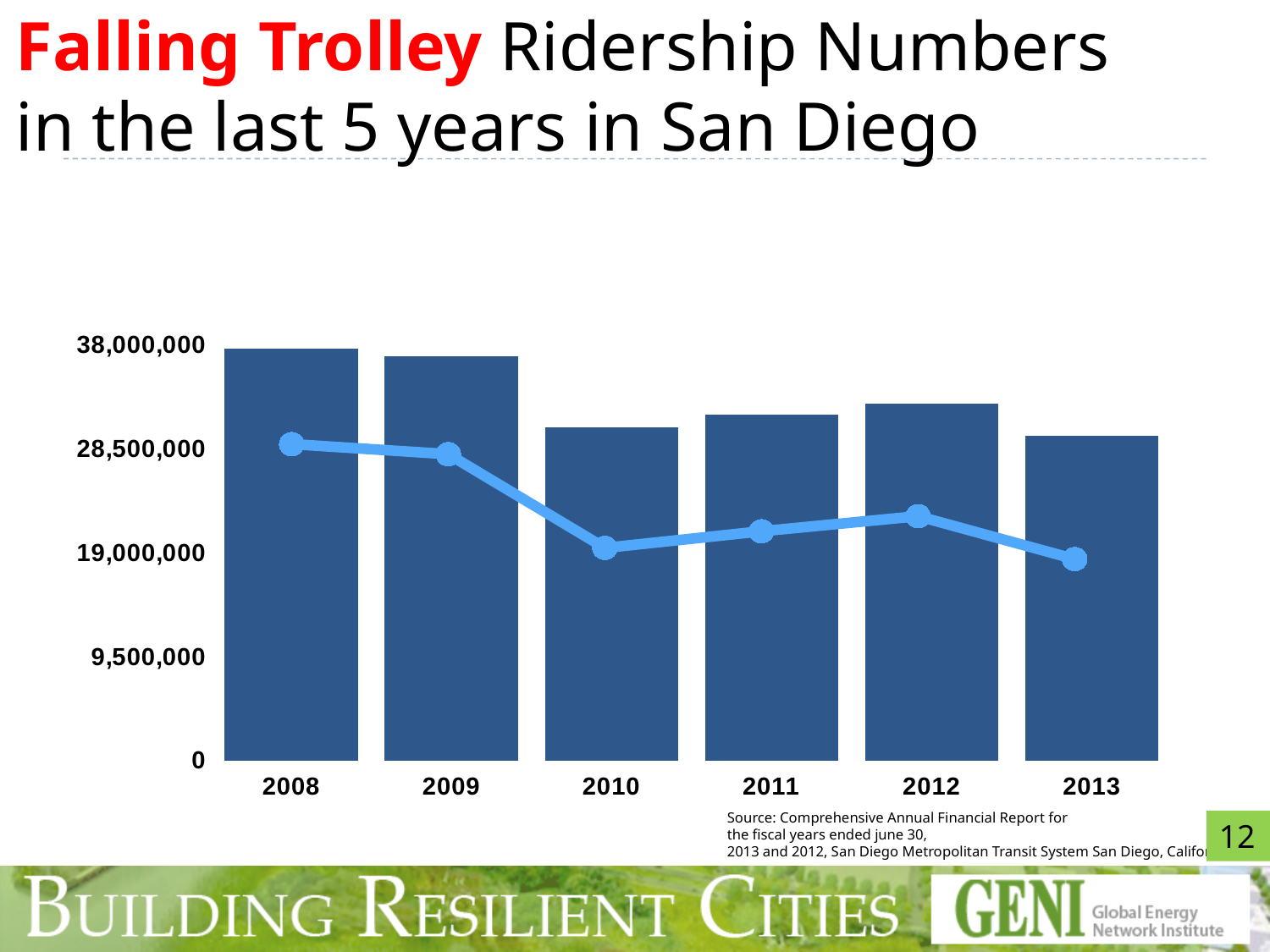
Is the bar for 2010 greater or less than 28,500,000? greater What kind of chart is shown on the slide? A bar chart with a line overlaid Which year has the tallest bar in the chart? 2008 Do the bar values generally rise or fall from 2008 to 2013? fall Which year has the shortest bar in the chart? 2013 Is the line point for 2012 greater or less than 19,000,000? greater Is the bar for 2013 greater or less than 38,000,000? less How many years are shown along the x axis of the chart? 6 What is the first year shown on the x axis of the chart? 2008 Which bar is taller, 2008 or 2013? 2008